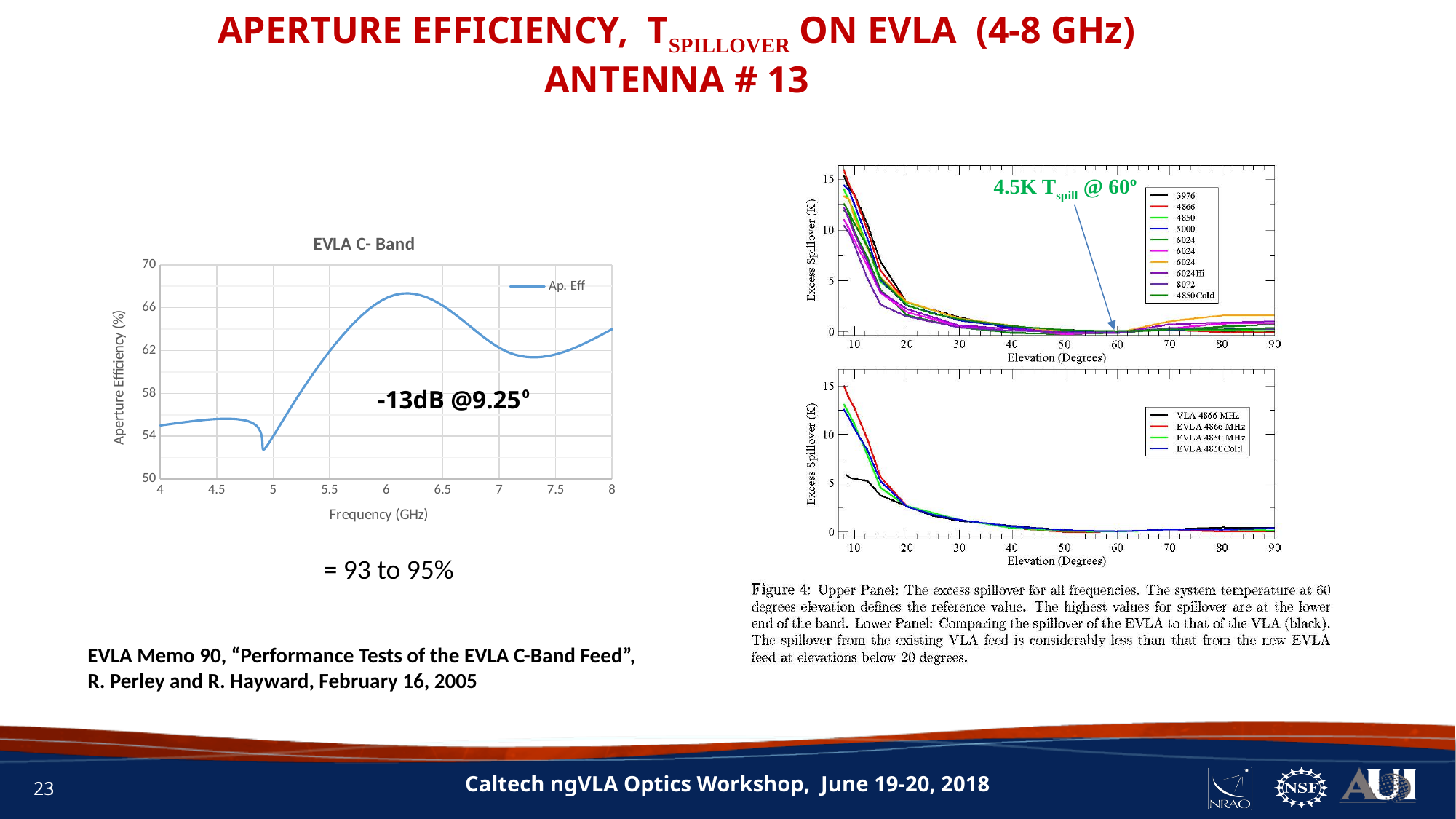
In the "EVLA C- Band" chart, is the peak aperture efficiency greater or less than 66%? greater How many series does the legend of the "EVLA C- Band" chart list? 1 How many entries does the legend of the upper Excess Spillover panel on the right list? 10 In the lower Excess Spillover panel, is the value for VLA 4866 MHz at 10 degrees elevation greater or less than 10 K? less How many entries does the legend of the lower Excess Spillover panel on the right list? 4 What kind of chart is the "EVLA C- Band" chart on the left? line chart In the "EVLA C- Band" chart, is the aperture efficiency at 4.5 GHz greater or less than 58%? less In the "EVLA C- Band" chart, does the aperture efficiency rise or fall between 5 GHz and 6 GHz? rise In the "EVLA C- Band" chart, which frequency has the higher aperture efficiency, 6 GHz or 7.5 GHz? 6 GHz What is the name of the series plotted in the "EVLA C- Band" chart? Ap. Eff In the lower Excess Spillover panel, which series has the higher value at 10 degrees elevation, VLA 4866 MHz or EVLA 4866 MHz? EVLA 4866 MHz In the "EVLA C- Band" chart, does the aperture efficiency rise or fall between 6.5 GHz and 7 GHz? fall